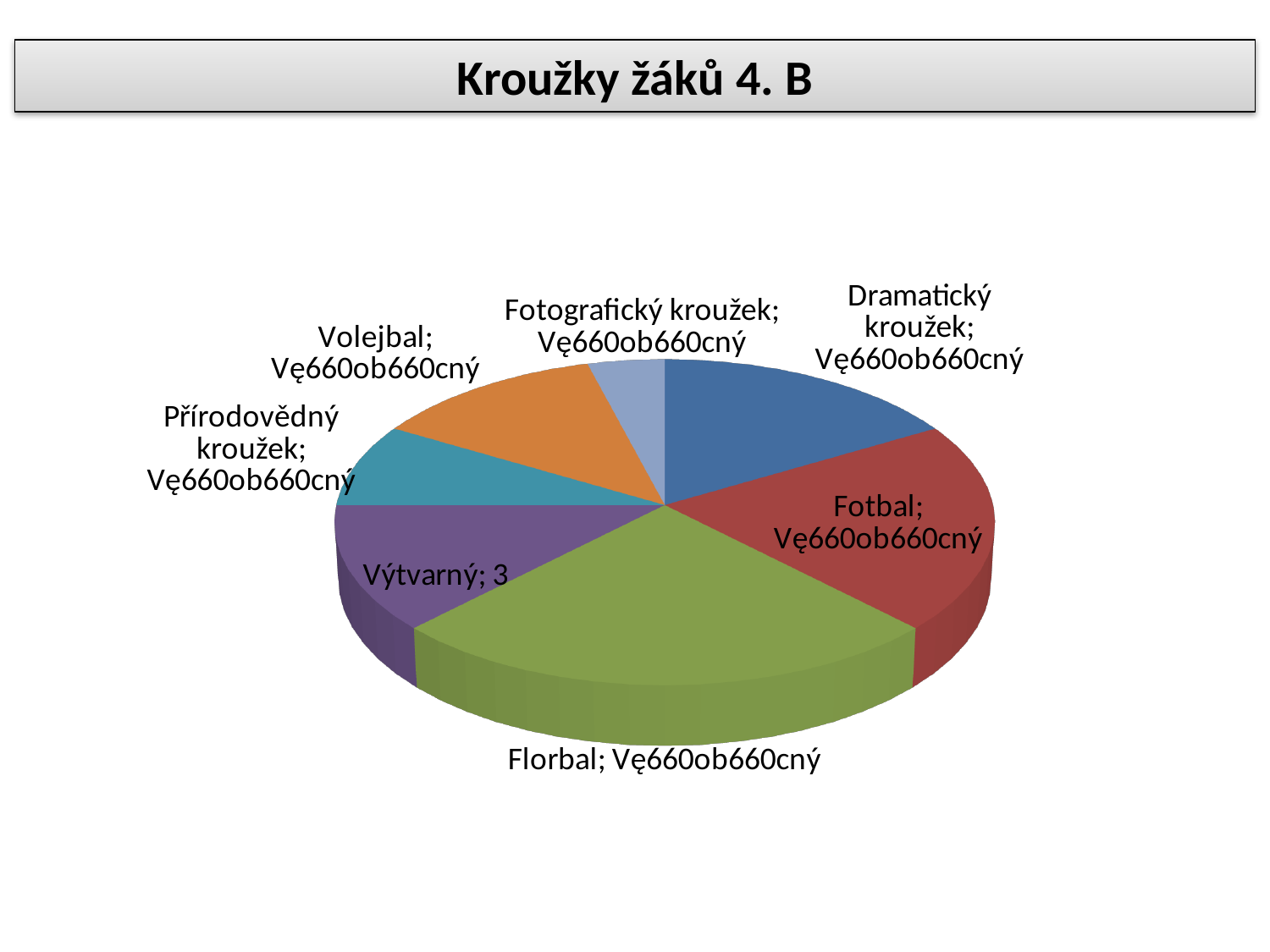
Which slice is larger, Florbal or Fotbal? Florbal Which slice is larger, Dramatický kroužek or Přírodovědný kroužek? Dramatický kroužek Which category has the largest slice of the pie? Florbal What is the title of the chart? Kroužky žáků 4. B What kind of chart is shown on the slide? pie chart How many slices does the pie chart have? 7 Which category has the smallest slice of the pie? Fotografický kroužek What value is shown for Výtvarný? 3 Which slice is larger, Volejbal or Fotografický kroužek? Volejbal What colour is the Florbal slice? green